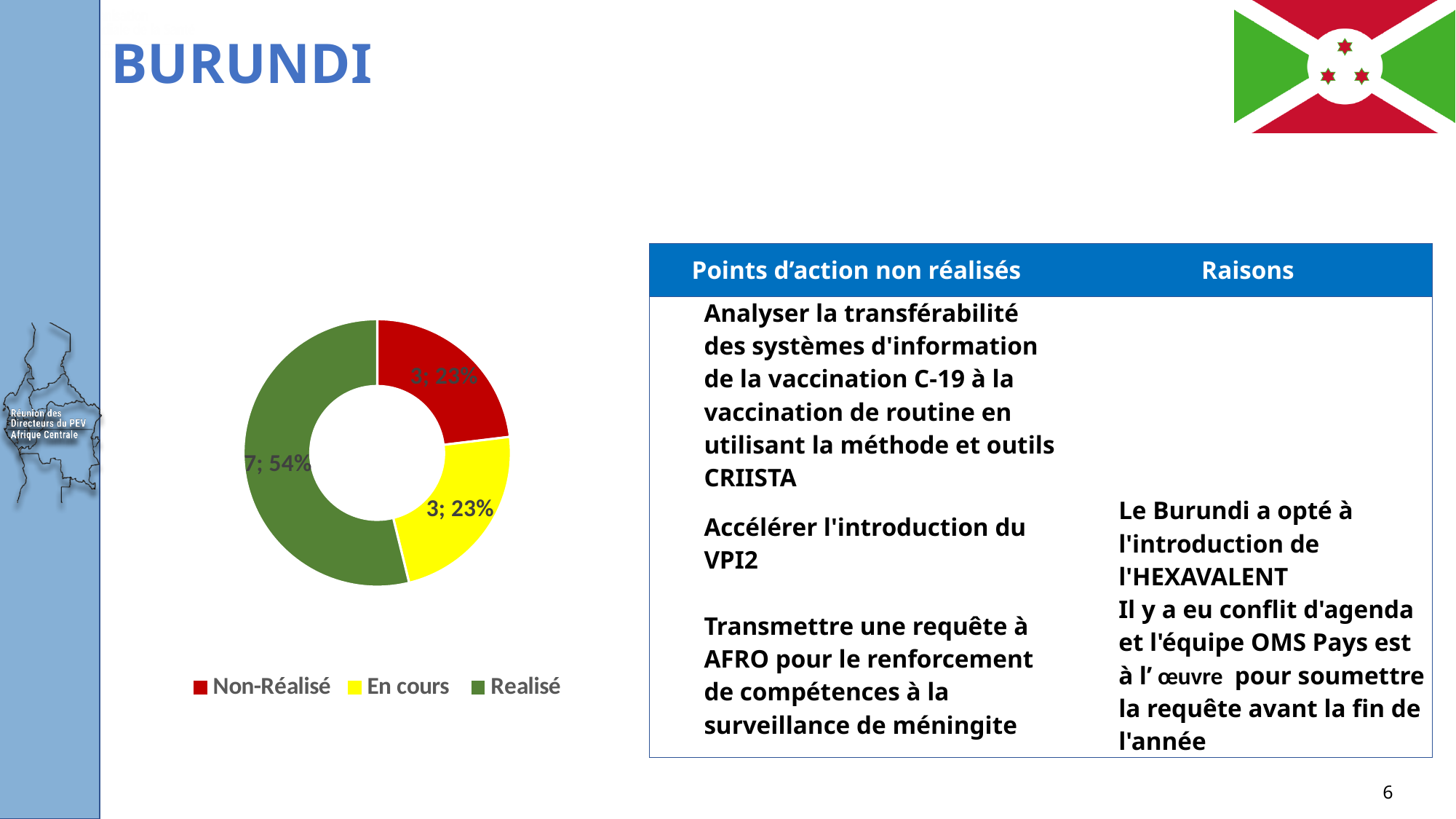
What is the value shown for En cours in the doughnut chart? 3 What percentage share does Non-Réalisé have in the doughnut chart? 23% What is the value shown for Non-Réalisé in the doughnut chart? 3 Which is larger in the doughnut chart, Realisé or En cours? Realisé What percentage share does Realisé have in the doughnut chart? 54% What kind of chart is shown on the slide? Doughnut (pie) chart What is the difference between the values for Realisé and Non-Réalisé in the doughnut chart? 4 How many categories does the doughnut chart show? 3 Which category has the largest share in the doughnut chart? Realisé What colour represents Non-Réalisé in the doughnut chart? Red How many entries does the legend of the doughnut chart list? 3 What is the value shown for Realisé in the doughnut chart? 7